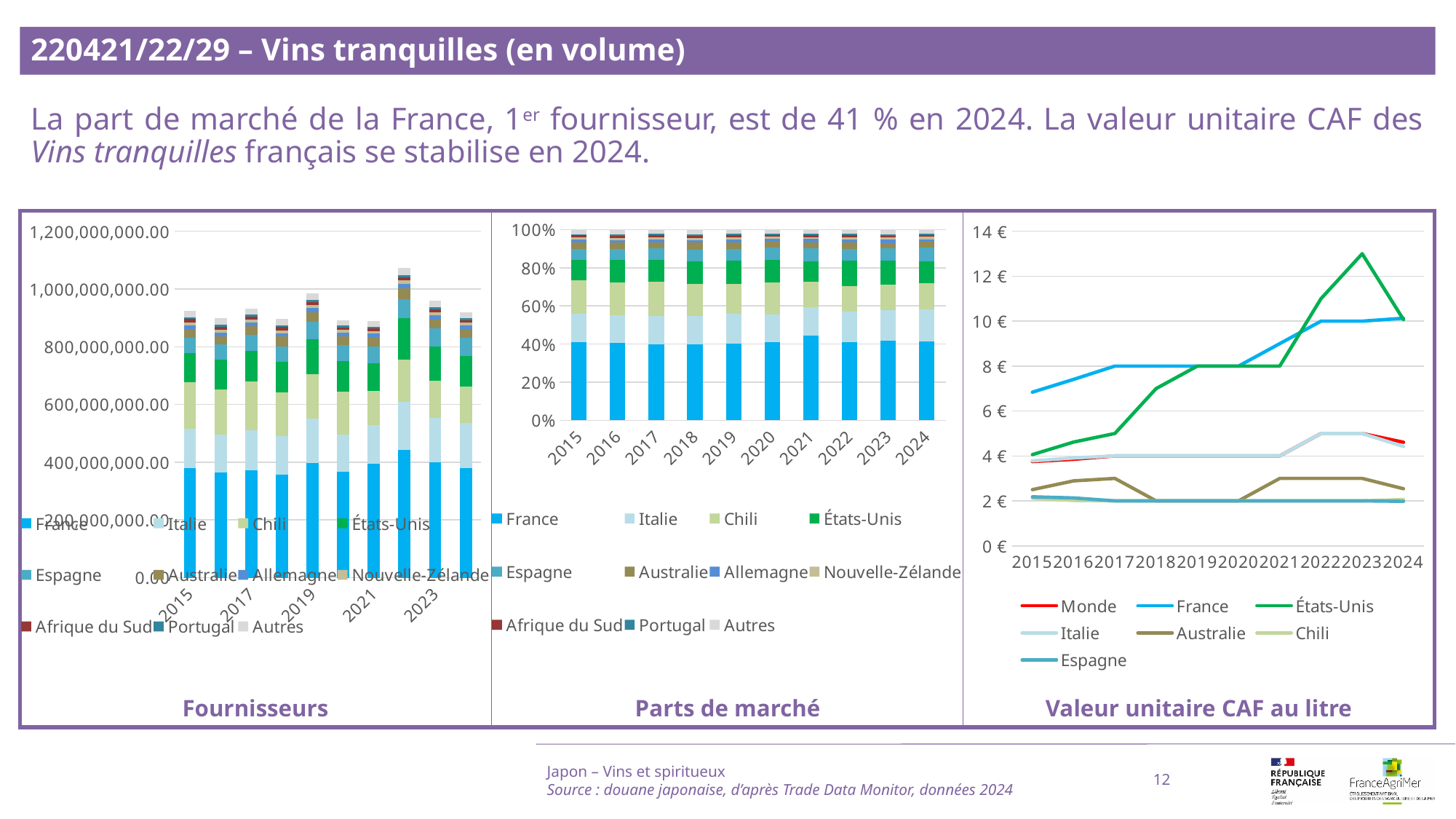
In the 'Fournisseurs' chart, is the total bar for 2015 greater or less than 1,000,000,000.00? less How many years are shown on the x axis of the 'Parts de marché' chart? 10 In the 'Fournisseurs' chart, which year has the tallest stacked bar? 2022 What kind of chart is the 'Fournisseurs' chart? Stacked bar chart In the 'Valeur unitaire CAF au litre' chart, is the value for France in 2015 greater or less than 8 €? less In the 'Valeur unitaire CAF au litre' chart, which is larger in 2024: France or Australie? France What kind of chart is the 'Valeur unitaire CAF au litre' chart? Line chart In the 'Valeur unitaire CAF au litre' chart, which series has the highest value in 2023? États-Unis How many series does the legend of the 'Valeur unitaire CAF au litre' chart list? 7 How many series does the legend of the 'Parts de marché' chart list? 11 In the 'Fournisseurs' chart, is the total bar for 2022 greater or less than 1,000,000,000.00? greater